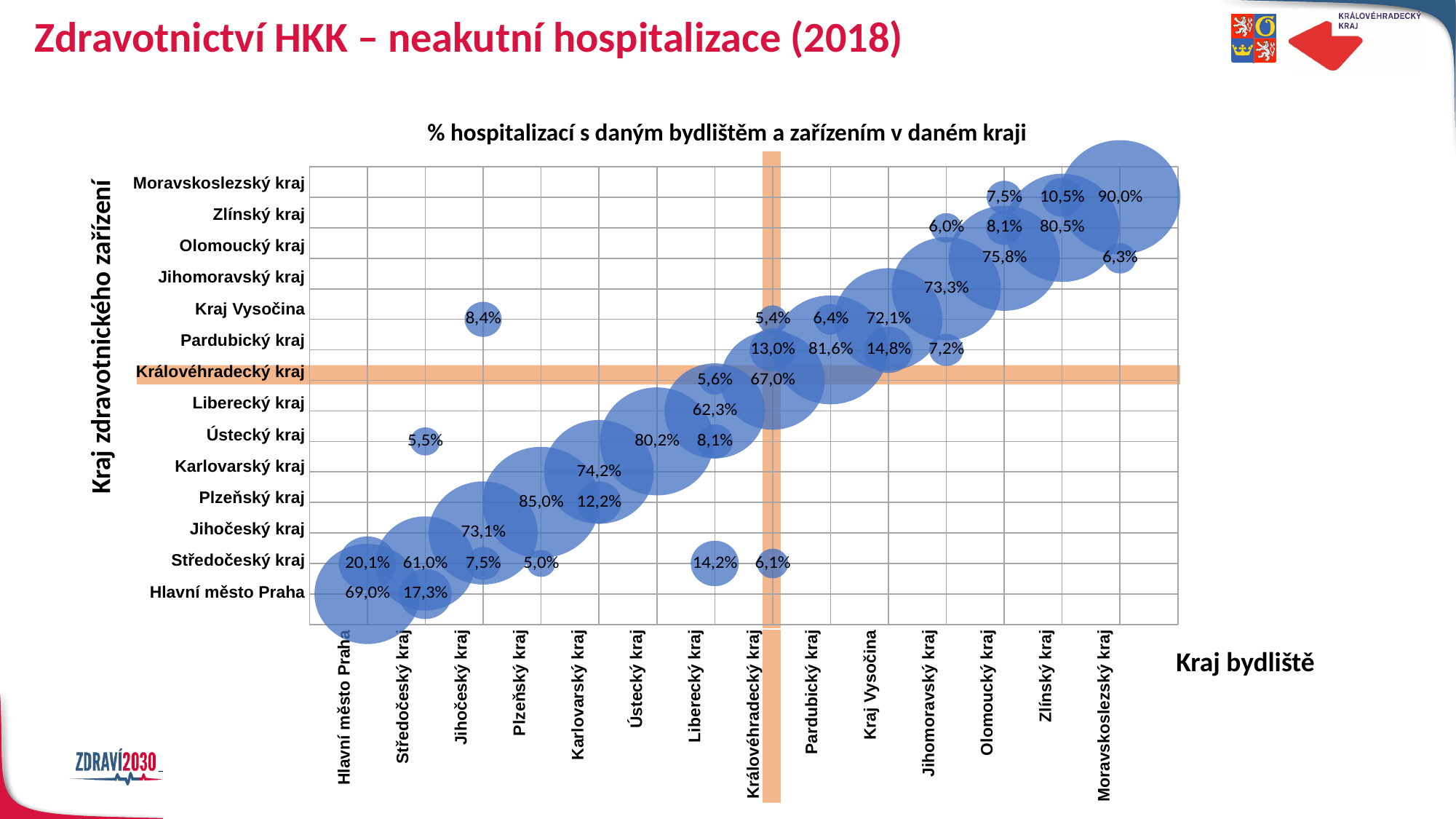
How many regions (kraje) are listed along the x axis (Kraj bydliště)? 14 What percentage is shown for residents of Pardubický kraj hospitalized in a facility in Pardubický kraj? 81,6% What percentage is shown for residents of Plzeňský kraj hospitalized in a facility in Plzeňský kraj? 85,0% What is the label of the vertical axis of the chart? Kraj zdravotnického zařízení Which is larger: the share of Plzeňský kraj residents treated in Plzeňský kraj, or the share of Hlavní město Praha residents treated in Hlavní město Praha? Plzeňský kraj (85,0%) What is the smallest percentage labelled in the chart? 5,0% What percentage is shown for residents of Hlavní město Praha hospitalized in a facility in Hlavní město Praha? 69,0% What is the difference between the highest labelled value (90,0%) and the value for Královéhradecký kraj residents treated in Královéhradecký kraj (67,0%)? 23,0 percentage points What is the title of the chart? % hospitalizací s daným bydlištěm a zařízením v daném kraji What percentage is shown for residents of Královéhradecký kraj hospitalized in a facility in Královéhradecký kraj? 67,0% What kind of chart is shown on the slide? Bubble chart Which region of residence has the highest labelled percentage in the chart? Moravskoslezský kraj (90,0%)